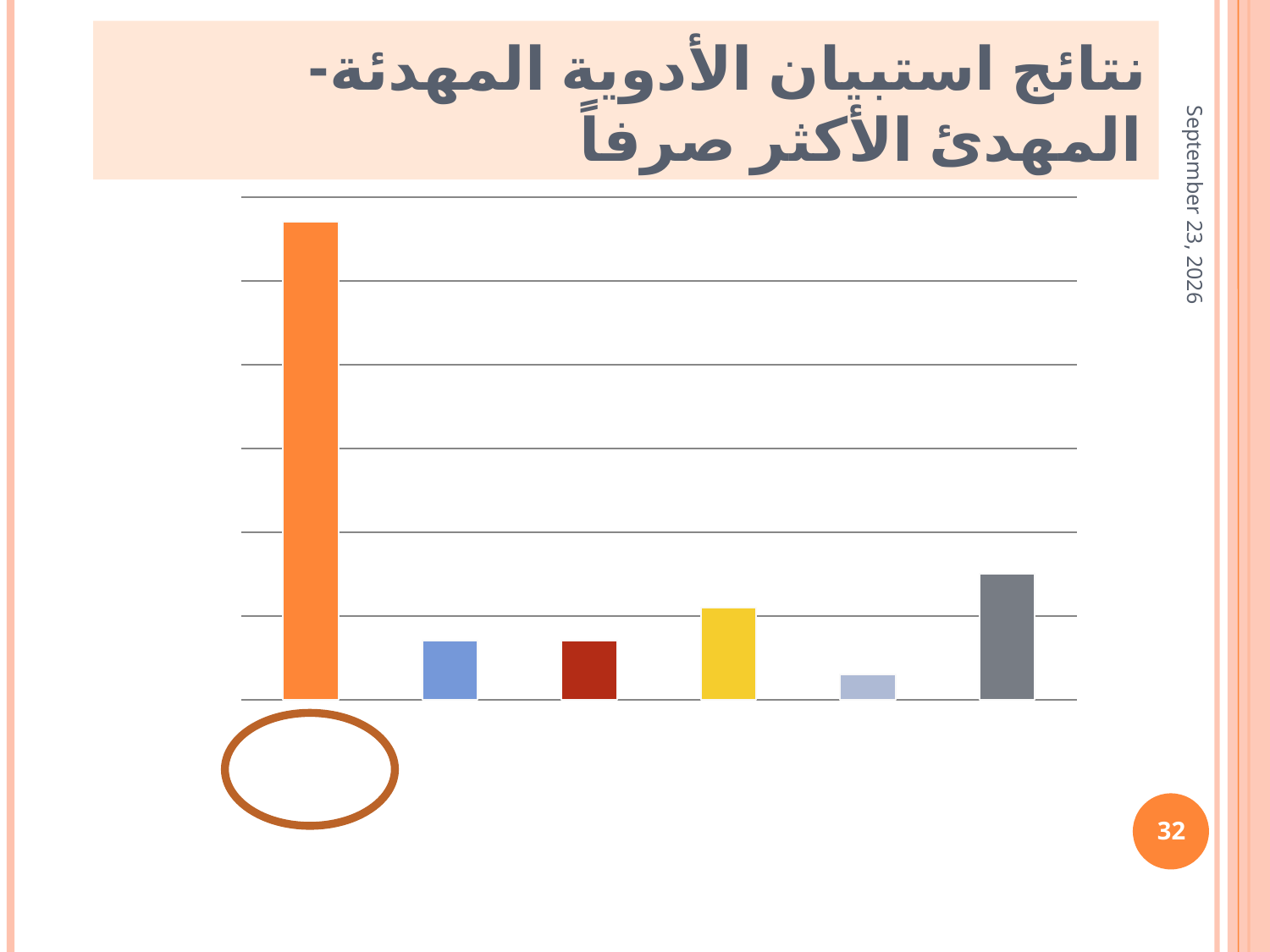
Which is taller, the yellow bar or the dark red bar? the yellow bar Which bar in the chart is the shortest? the fifth (light blue) bar How many bars does the chart contain? 6 Which bar is the second tallest in the chart? the sixth (gray) bar What is the title of the slide containing the chart? نتائج استبيان الأدوية المهدئة- المهدئ الأكثر صرفاً Which is taller, the gray bar or the yellow bar? the gray bar What kind of chart is shown on the slide? bar chart Which bar in the chart is the tallest? the first (orange) bar Which is taller, the first (orange) bar or the last (gray) bar? the first (orange) bar Which bar has an oval drawn beneath it on the slide? the first (orange) bar